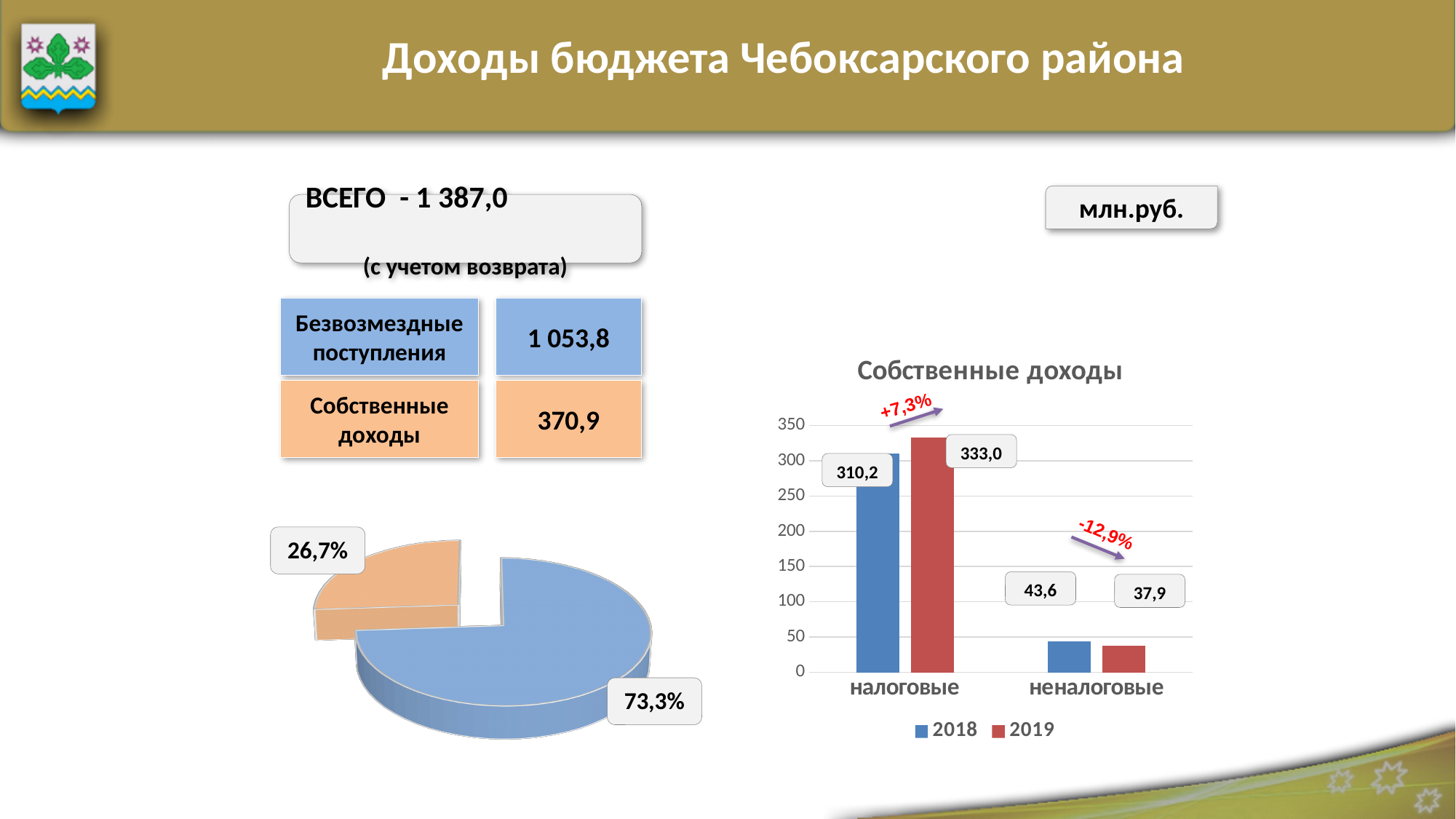
In the pie chart on the left side of the slide, what share does the smaller (orange) slice have? 26,7% In the bar chart titled "Собственные доходы", how many series does the legend list? 2 In the bar chart titled "Собственные доходы", what is the difference between the 2019 and 2018 values for налоговые? 22,8 In the bar chart titled "Собственные доходы", how many categories are shown on the x axis? 2 What kind of chart is the chart on the left side of the slide? pie chart In the pie chart on the left side of the slide, what share does the larger (blue) slice have? 73,3% In the bar chart titled "Собственные доходы", which is larger for неналоговые: the 2018 value or the 2019 value? 2018 In the bar chart titled "Собственные доходы", is the 2018 value for налоговые greater or less than 300? greater In the bar chart titled "Собственные доходы", what is the value for налоговые in 2018? 310,2 In the bar chart titled "Собственные доходы", what is the value for налоговые in 2019? 333,0 In the bar chart titled "Собственные доходы", what is the value for неналоговые in 2018? 43,6 In the bar chart titled "Собственные доходы", what is the value for неналоговые in 2019? 37,9